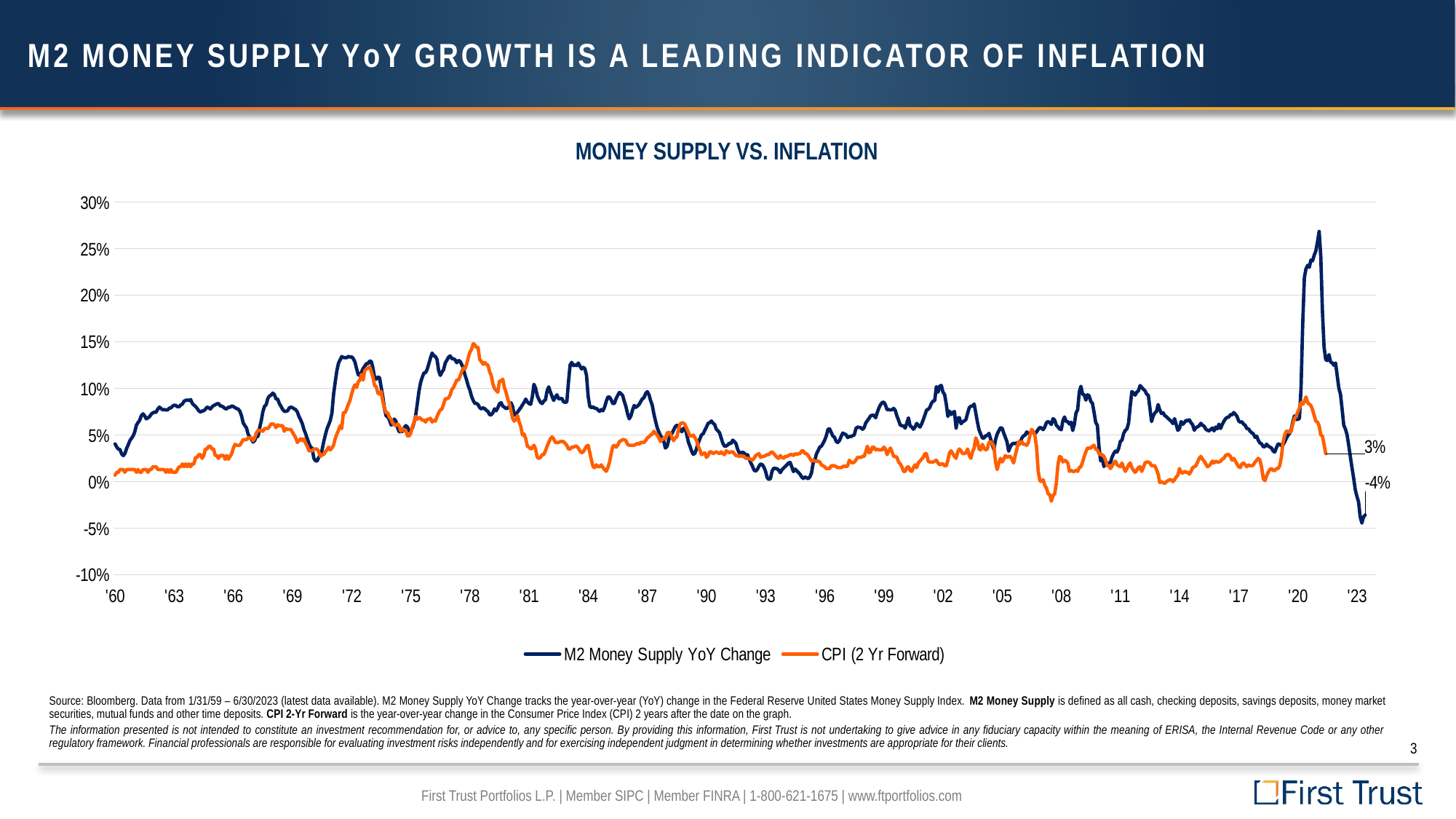
At the right end of the chart, which series has the larger labeled value, M2 Money Supply YoY Change or CPI (2 Yr Forward)? CPI (2 Yr Forward) What is the difference between the labeled end values of CPI (2 Yr Forward) (3%) and M2 Money Supply YoY Change (-4%)? 7% What is the latest labeled value of the M2 Money Supply YoY Change series at the right end of the chart? -4% What kind of chart is shown on the slide? line chart Is the peak value of CPI (2 Yr Forward) around '78 greater or less than 10%? greater Does the M2 Money Supply YoY Change series rise or fall from its peak around 2021 to '23? fall How many series does the legend list? 2 What colour is the line for CPI (2 Yr Forward)? orange What is the latest labeled value of the CPI (2 Yr Forward) series at the right end of the chart? 3% Which series reaches the highest value anywhere on the chart? M2 Money Supply YoY Change What is the title of the chart? MONEY SUPPLY VS. INFLATION Is the peak value of M2 Money Supply YoY Change around 2021 greater or less than 25%? greater